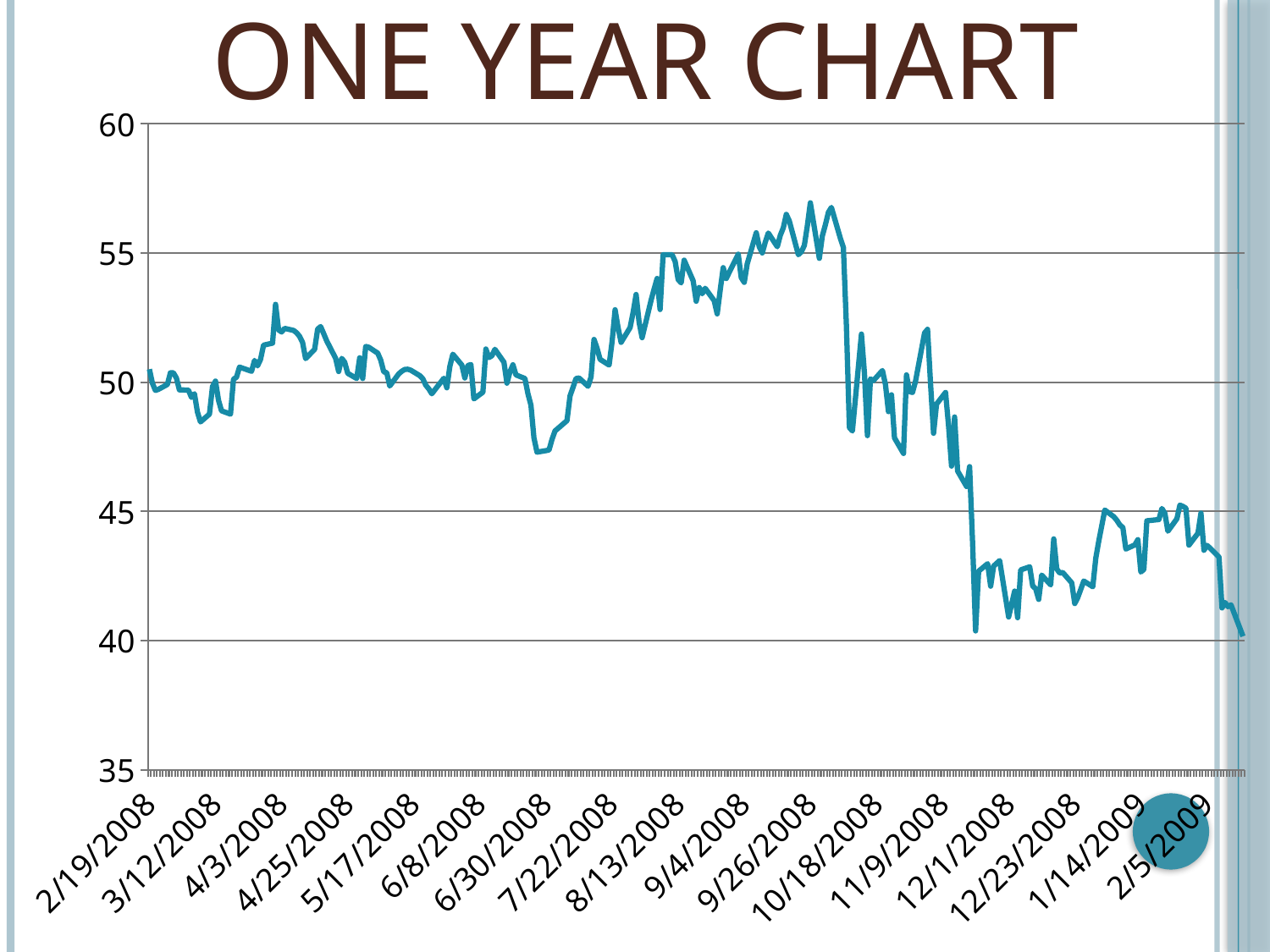
What is the title of the chart? ONE YEAR CHART Is the value at 2/19/2008 greater or less than 45? greater Is the value at 6/30/2008 greater or less than 50? less Overall, does the line rise or fall from 2/19/2008 to 2/5/2009? fall What kind of chart is shown on the slide? line chart Is the value at 2/5/2009 greater or less than 45? less Which is larger, the value at 2/19/2008 or the value at 2/5/2009? 2/19/2008 How many date labels are shown on the x axis? 17 Which is larger, the value at 9/4/2008 or the value at 12/1/2008? 9/4/2008 What is the highest value shown on the y axis? 60